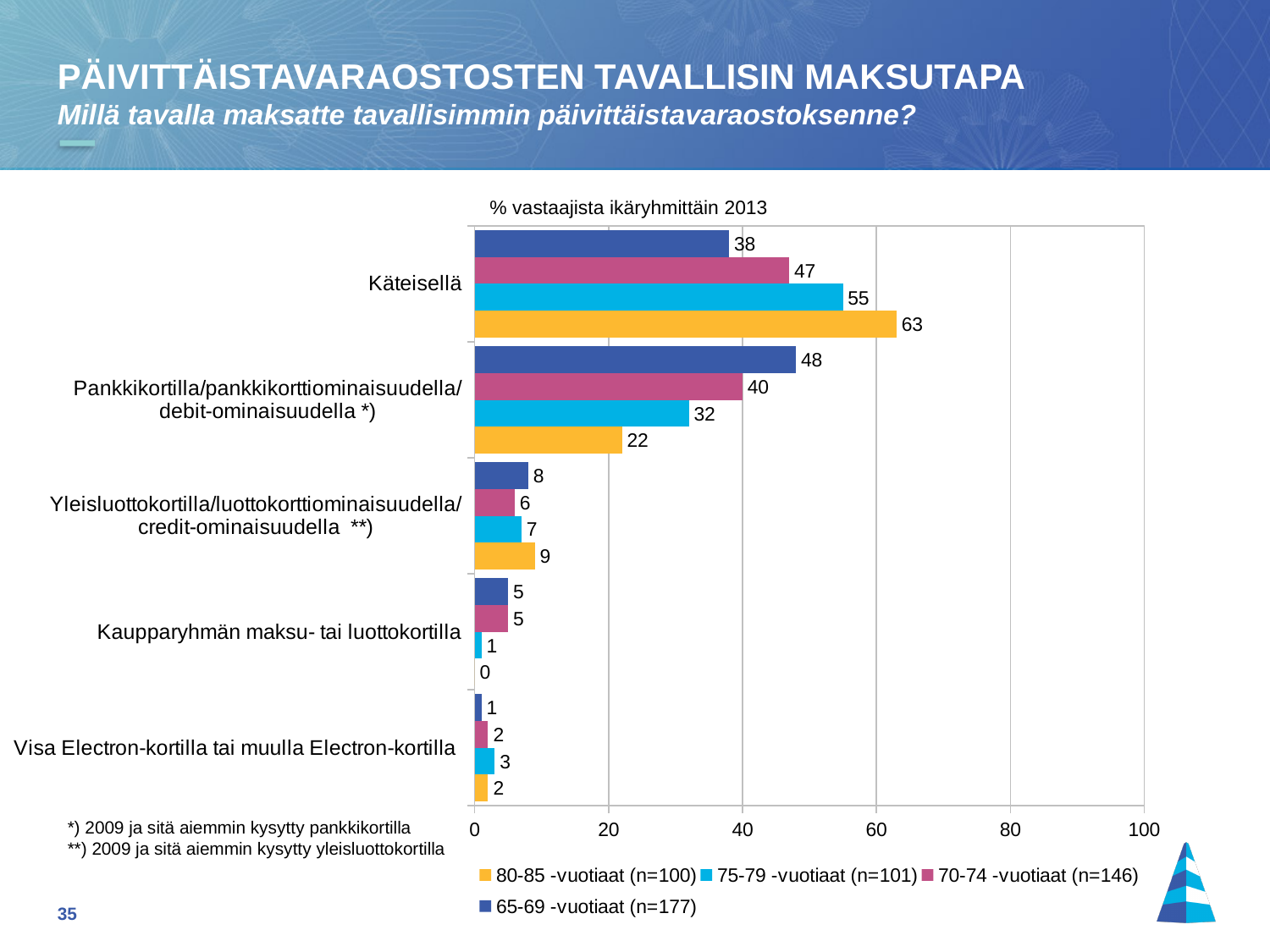
How many payment-method categories are shown on the chart? 5 In the Yleisluottokortilla/luottokorttiominaisuudella/credit-ominaisuudella category, which is larger: the value for 80-85 -vuotiaat or for 70-74 -vuotiaat? 80-85 -vuotiaat What is the sample size (n) for the 65-69 -vuotiaat group shown in the legend? 177 What is the value for 80-85 -vuotiaat in the Käteisellä category? 63 What type of chart is shown on the slide? bar chart What is the subtitle text shown above the chart? % vastaajista ikäryhmittäin 2013 How many series does the legend list? 4 What is the value for 75-79 -vuotiaat in the Kaupparyhmän maksu- tai luottokortilla category? 1 What is the value for 65-69 -vuotiaat in the Pankkikortilla/pankkikorttiominaisuudella/debit-ominaisuudella category? 48 Which age group has the highest value in the Käteisellä category? 80-85 -vuotiaat What is the difference between the 80-85 -vuotiaat and 65-69 -vuotiaat values in the Käteisellä category? 25 Which age group has the lowest value in the Pankkikortilla/pankkikorttiominaisuudella/debit-ominaisuudella category? 80-85 -vuotiaat